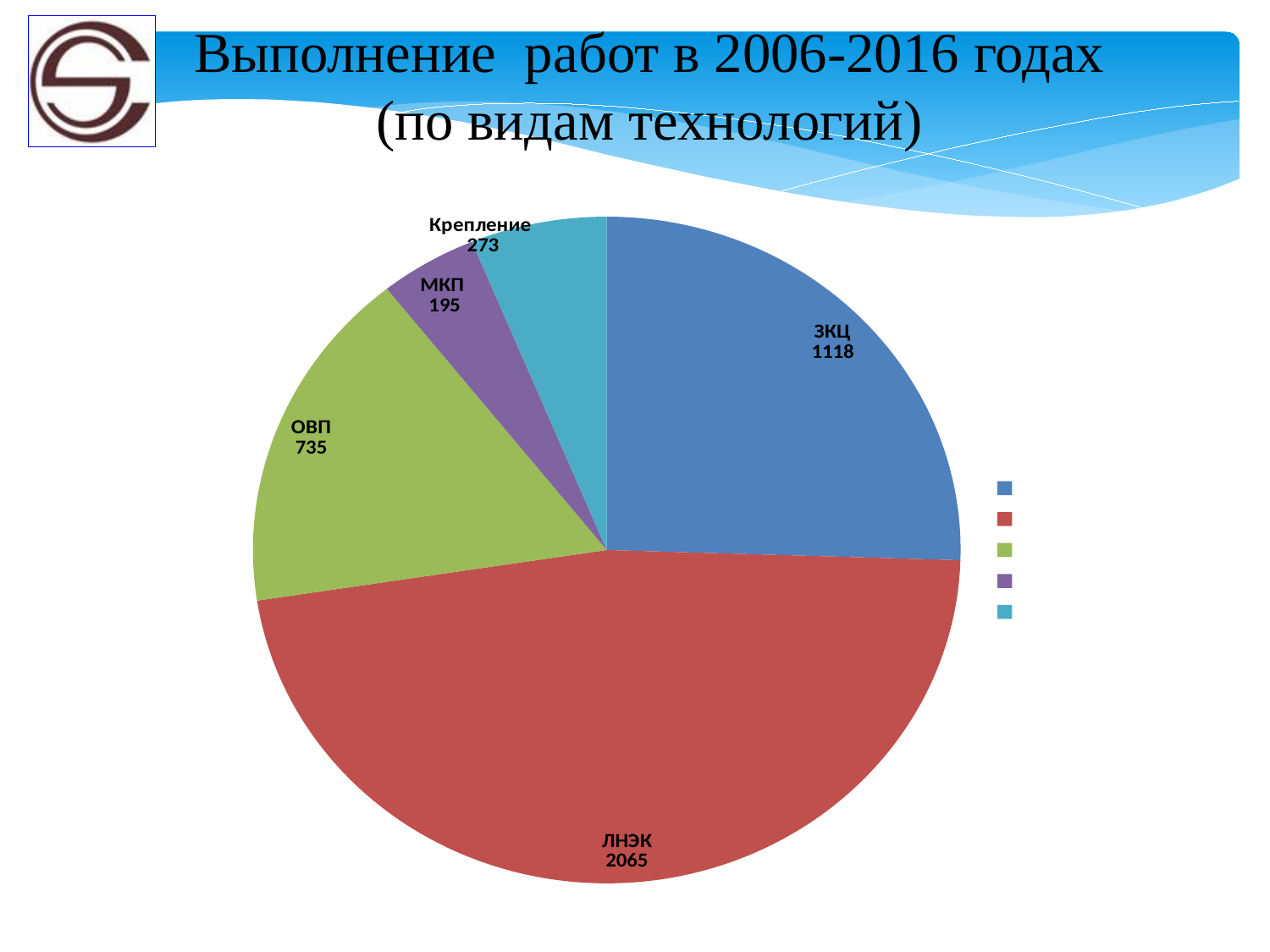
What is the value for ЗКЦ? 1118 Which category has the largest slice? ЛНЭК What is the value for Крепление? 273 What type of chart is shown on the slide? pie chart Which category has the smallest slice? МКП How many slices does the pie chart have? 5 What is the value for ЛНЭК? 2065 What is the value for ОВП? 735 What is the value for МКП? 195 Which is larger, the value for Крепление or the value for МКП? Крепление What is the difference between the values for ЛНЭК and ЗКЦ? 947 What is the total of all slices in the pie chart? 4386